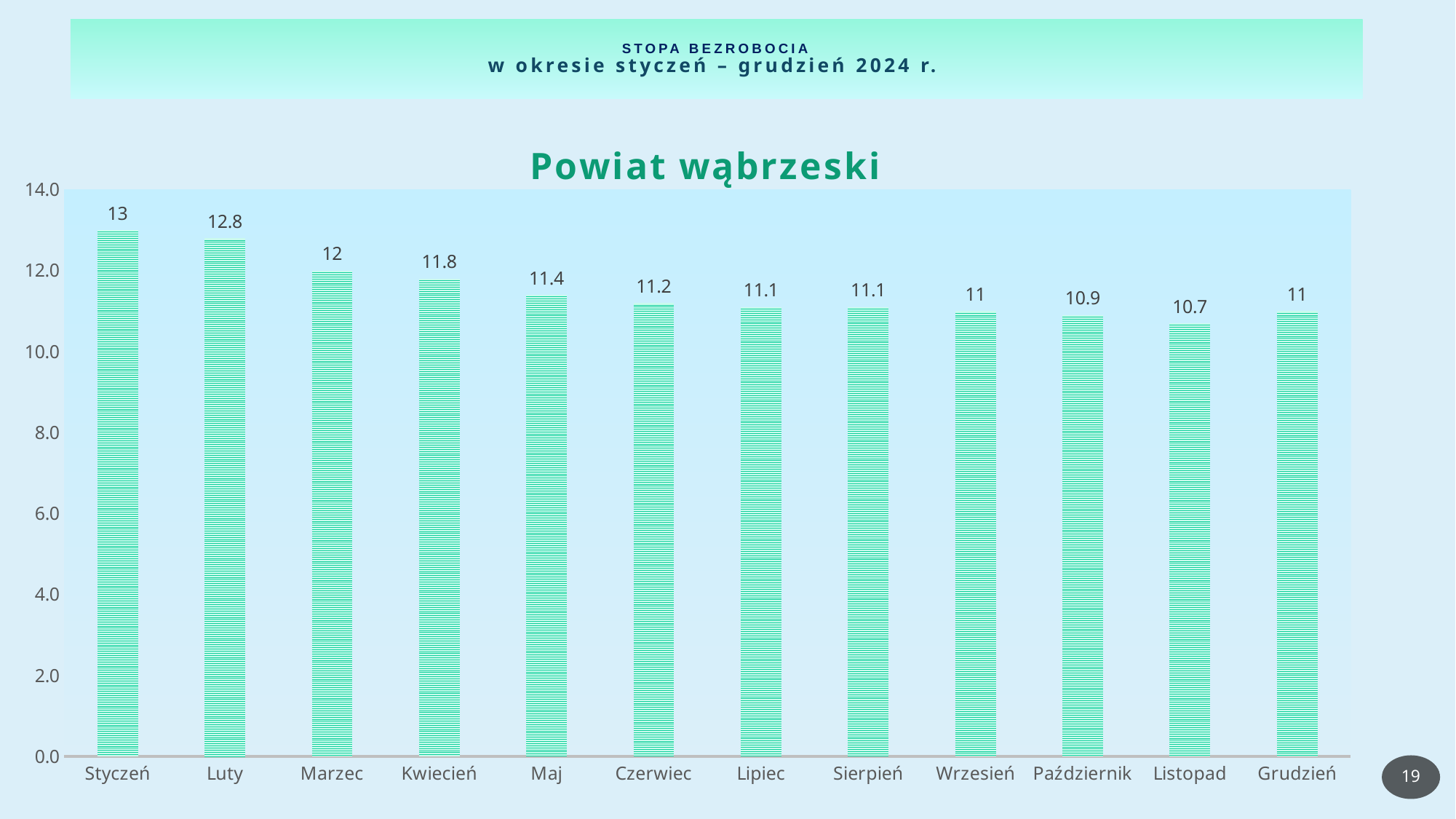
What is the value for Styczeń? 13 Which is larger, the value for Kwiecień or the value for Czerwiec? Kwiecień Is the value for Luty greater or less than 12.0? greater What is the value for Maj? 11.4 Which month has the highest value? Styczeń How many months are shown on the x axis? 12 Which month has the lowest value? Listopad What is the difference between the values for Styczeń and Grudzień? 2 What is the title of the chart? Powiat wąbrzeski What is the difference between the values for Luty and Marzec? 0.8 What is the value for Październik? 10.9 What kind of chart is shown on the slide? bar chart